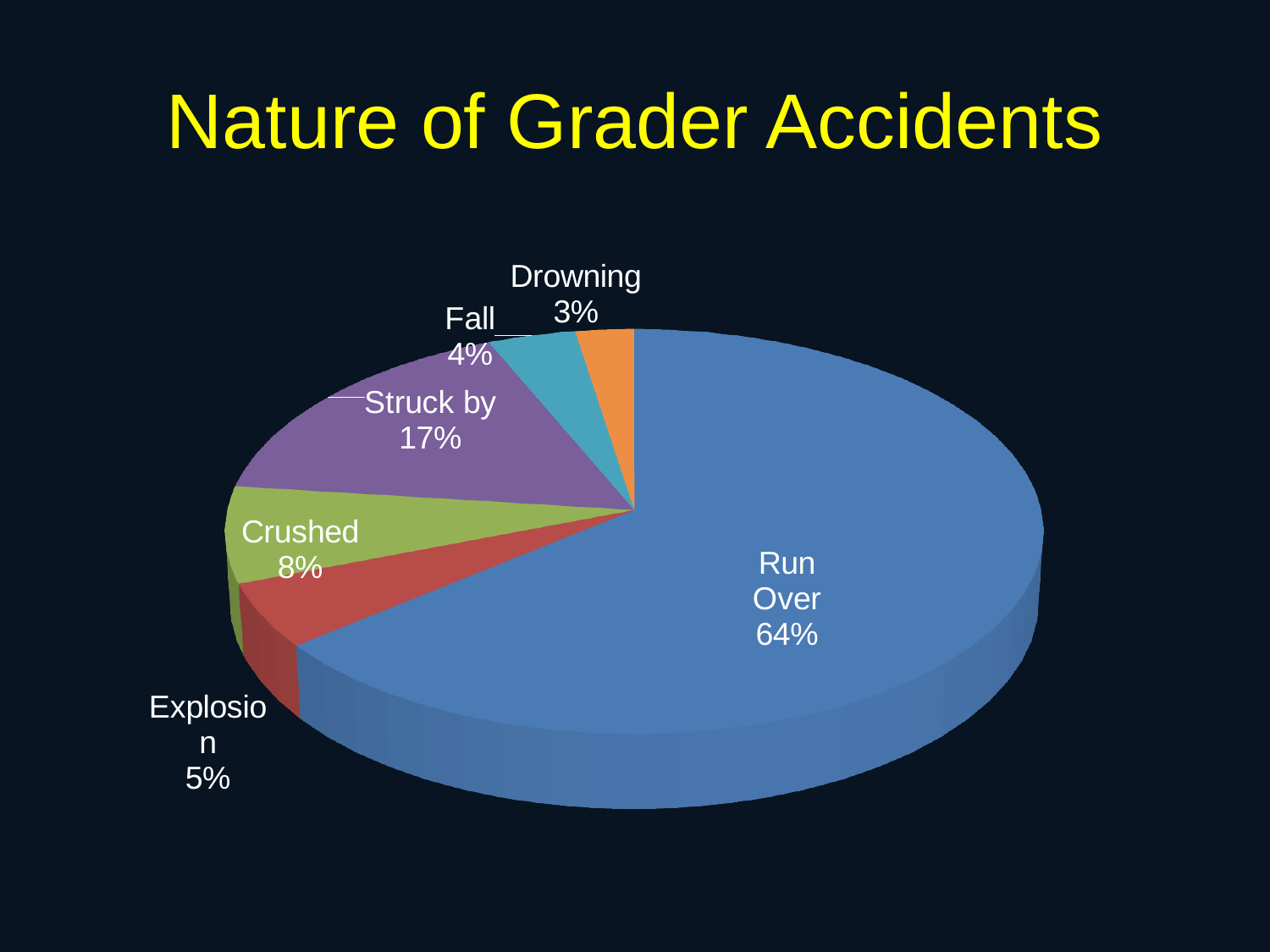
What is the difference in percentage points between Run Over and Struck by? 47 How many categories does the pie chart show? 6 What is the title of the chart? Nature of Grader Accidents What share of grader accidents is Struck by? 17% What share of grader accidents is Run Over? 64% What share of grader accidents is Crushed? 8% Which category has the smallest share of grader accidents? Drowning Which category has the largest share of grader accidents? Run Over Which is larger, the share for Crushed or the share for Fall? Crushed What kind of chart is shown on the slide? pie chart